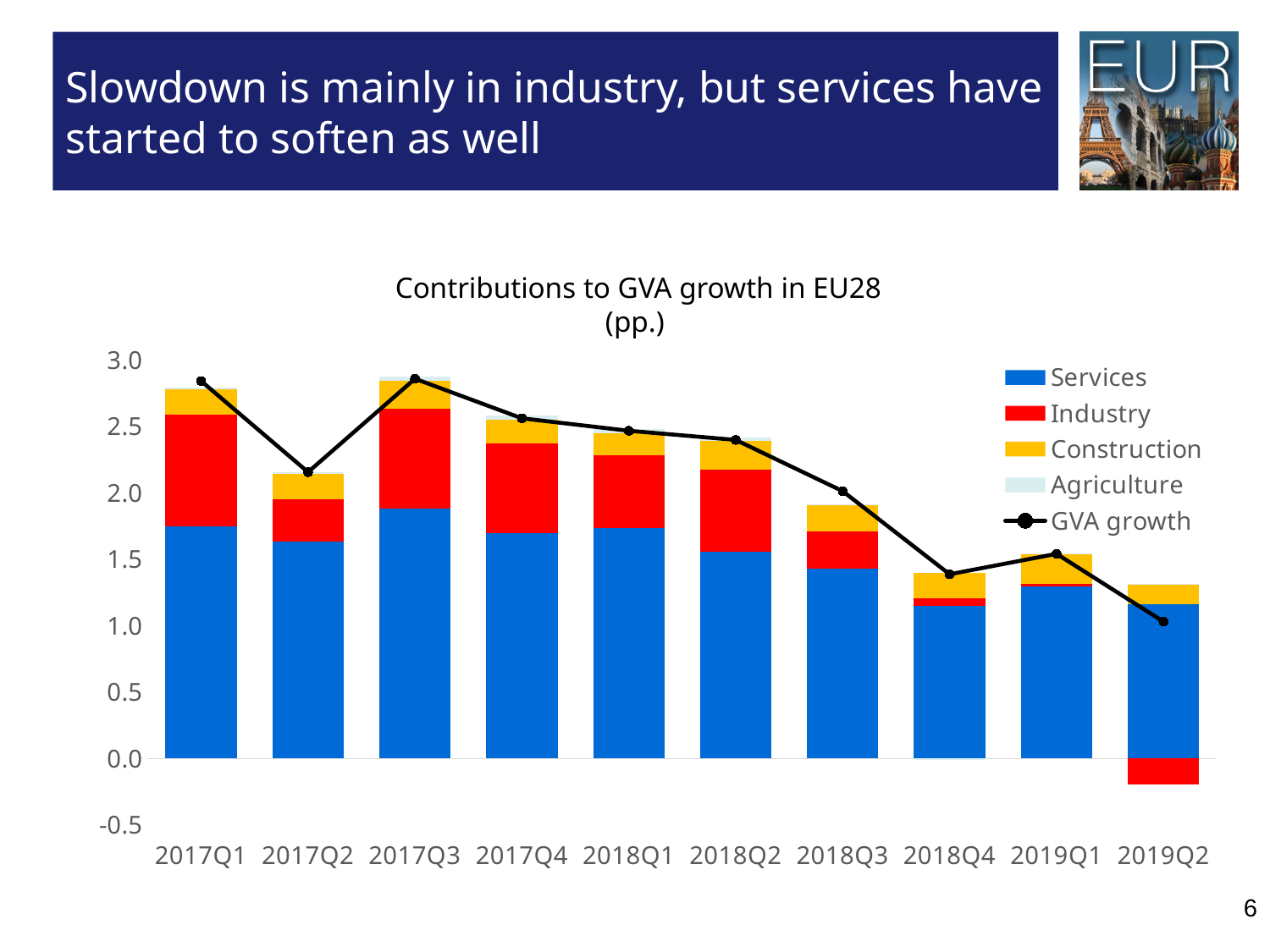
Which series is plotted as a black line with markers? GVA growth In which quarter is the Industry contribution negative? 2019Q2 How many quarters are shown on the x axis of the chart? 10 Does GVA growth overall rise or fall from 2017Q1 to 2019Q2? fall Is the Services contribution in 2018Q3 greater or less than 1.5? less In which quarter is the Services contribution highest? 2017Q3 What is the title of the chart? Contributions to GVA growth in EU28 (pp.) How many series does the legend list? 5 Is GVA growth in 2018Q4 greater or less than 1.5? less What kind of chart is shown on the slide? Stacked bar chart with a line In which quarter is GVA growth lowest? 2019Q2 Is GVA growth in 2017Q2 greater or less than 2.0? greater